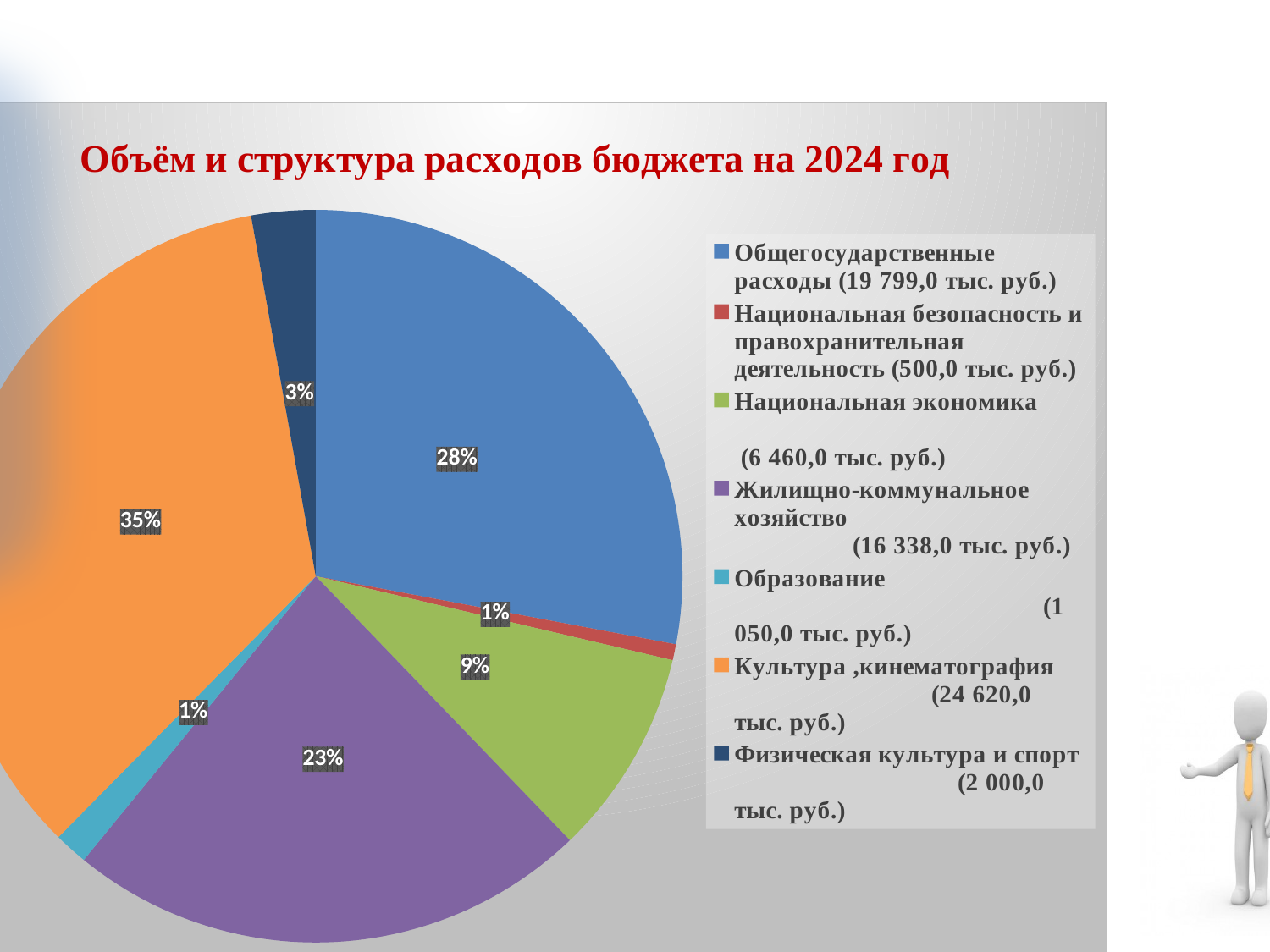
Which slice is larger: Жилищно-коммунальное хозяйство or Национальная экономика? Жилищно-коммунальное хозяйство What kind of chart is shown on the slide? pie chart What share of the pie does Физическая культура и спорт take? 3% What is the difference in percentage points between the Культура, кинематография slice and the Общегосударственные расходы slice? 7% What share of the pie does Национальная экономика take? 9% What share of the pie does Общегосударственные расходы take? 28% According to the legend, what is the amount for Жилищно-коммунальное хозяйство? 16 338,0 тыс. руб. Which category has the largest slice of the pie? Культура, кинематография What is the title of the chart? Объём и структура расходов бюджета на 2024 год How many slices does the pie chart have? 7